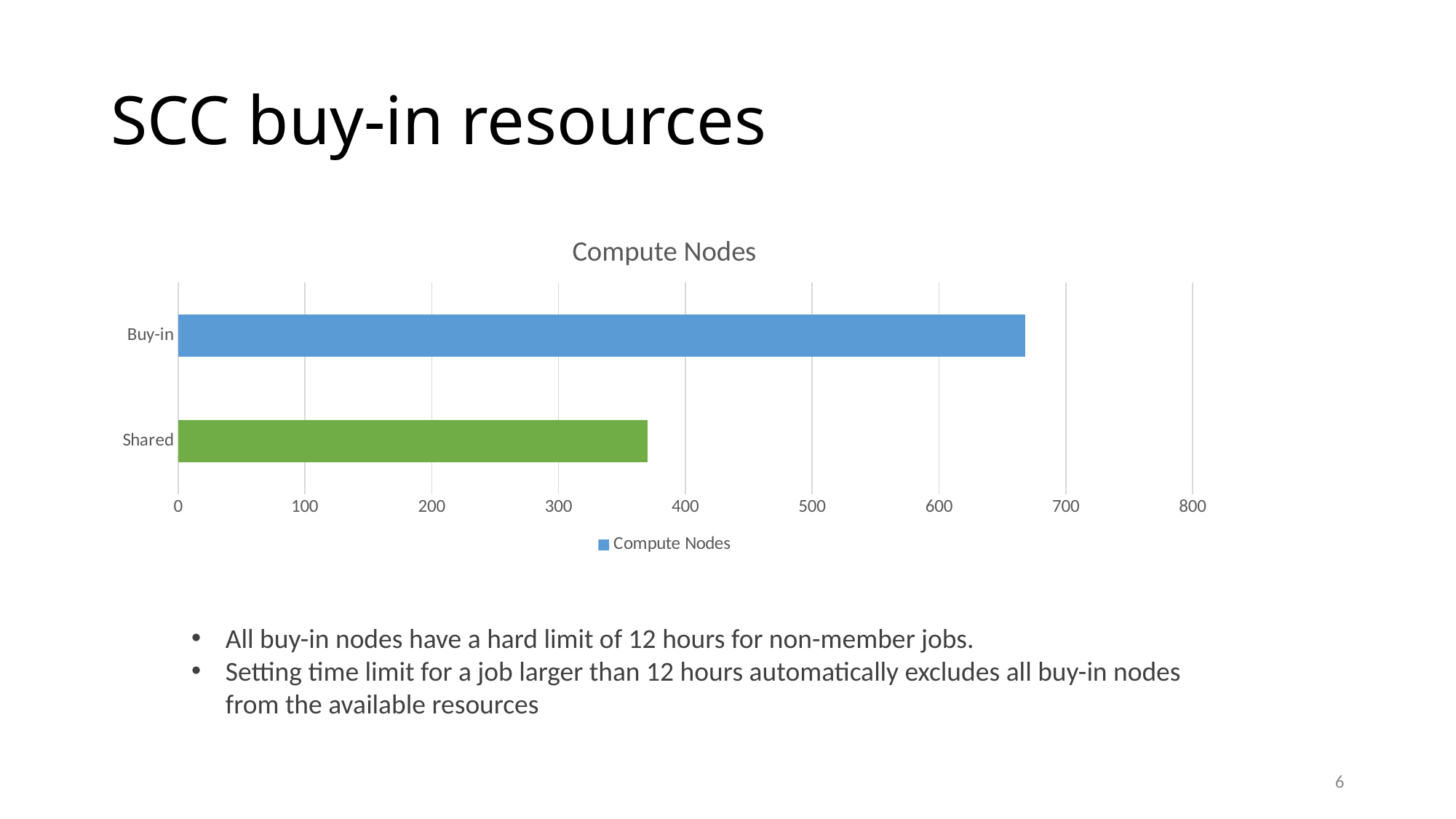
Is the value for Shared greater or less than 300? greater Is the value for Buy-in greater or less than 700? less What is the name of the series shown in the legend? Compute Nodes How many categories does the chart show? 2 Is the value for Buy-in greater or less than 600? greater What kind of chart is shown on the slide? bar chart Which has more compute nodes, Buy-in or Shared? Buy-in Which category has the highest number of compute nodes? Buy-in Which category has the lowest number of compute nodes? Shared How many series does the legend list? 1 What is the title of the chart? Compute Nodes